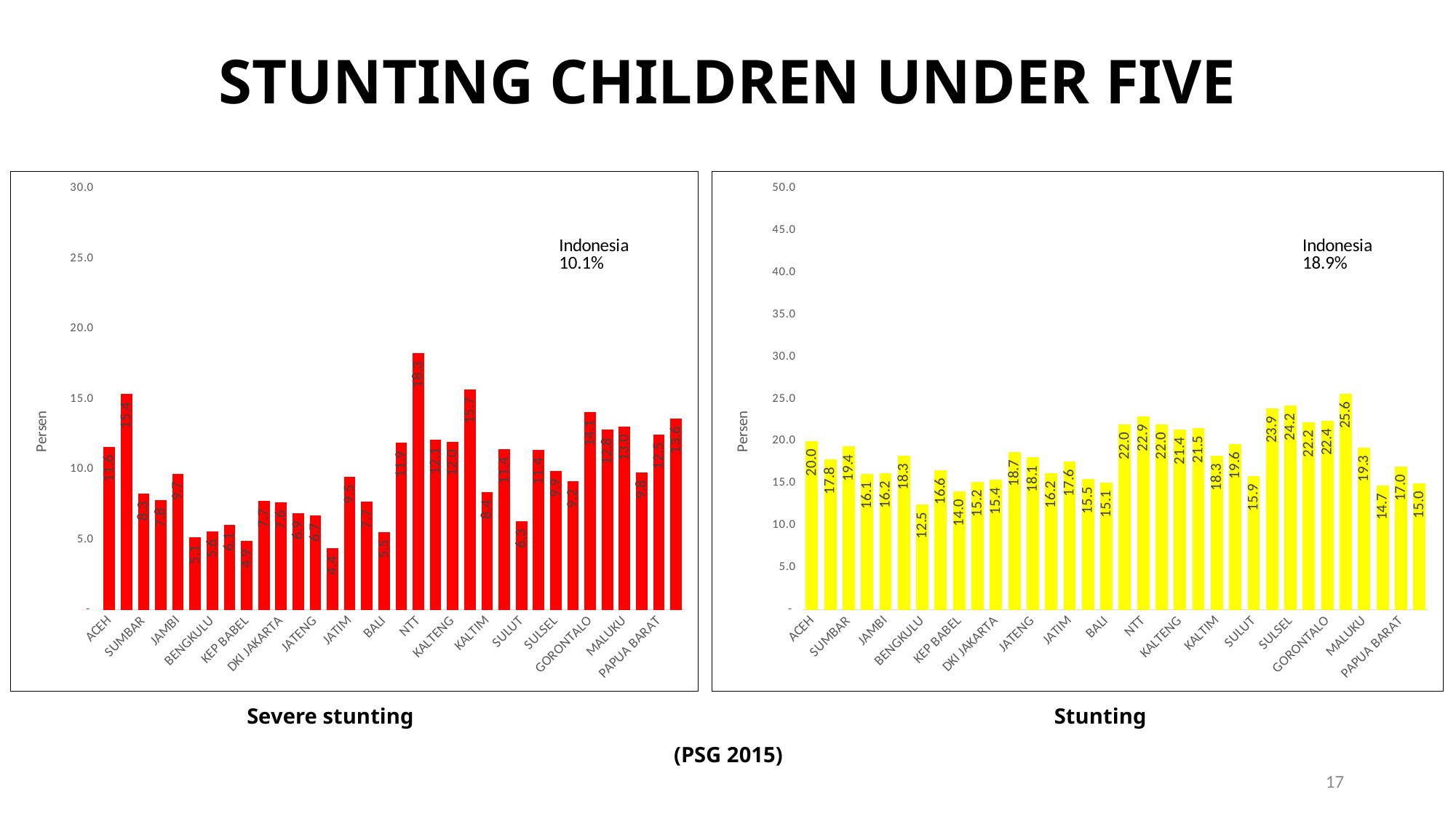
What is the difference between the Indonesia value in the Stunting chart and the Indonesia value in the Severe stunting chart? 8.8 In the Severe stunting chart, what is the highest value plotted? 18.3 In the Stunting chart, what is the national Indonesia value shown? 18.9% In the Stunting chart, what is the value for ACEH? 20.0 In the Severe stunting chart, which labeled province has the highest value? NTT Is the value for ACEH in the Stunting chart greater or less than the value for ACEH in the Severe stunting chart? greater In the Severe stunting chart, what is the lowest value plotted? 4.4 In the Severe stunting chart, what is the national Indonesia value shown? 10.1% In the Stunting chart, what is the lowest value plotted? 12.5 In the Severe stunting chart, what is the value for ACEH? 11.6 What kind of chart is the Severe stunting chart? bar chart In the Stunting chart, what is the highest value plotted? 25.6